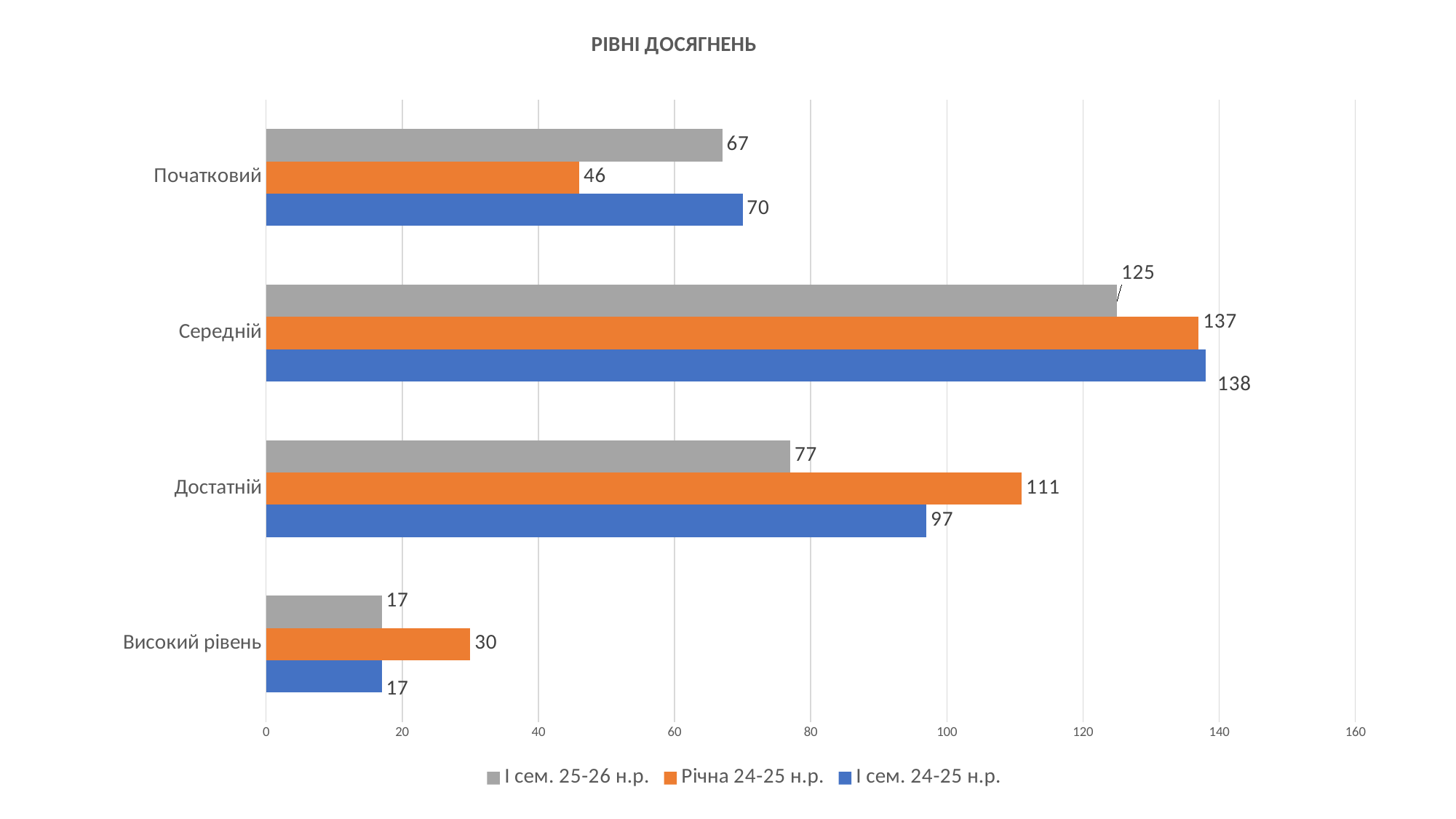
How many categories are shown on the chart? 4 What is the value for Початковий in the series І сем. 25-26 н.р.? 67 Which category has the lowest value in the series Річна 24-25 н.р.? Високий рівень What is the difference between the І сем. 24-25 н.р. and І сем. 25-26 н.р. values for Високий рівень? 0 What is the value for Достатній in the series Річна 24-25 н.р.? 111 Which is larger for Початковий: the value for І сем. 24-25 н.р. or the value for Річна 24-25 н.р.? І сем. 24-25 н.р. What type of chart is shown on the slide? bar chart What is the title of the chart? РІВНІ ДОСЯГНЕНЬ What is the value for Середній in the series І сем. 24-25 н.р.? 138 What is the difference between the Річна 24-25 н.р. and І сем. 25-26 н.р. values for Достатній? 34 Which category has the highest value in the series І сем. 25-26 н.р.? Середній How many series does the legend list? 3